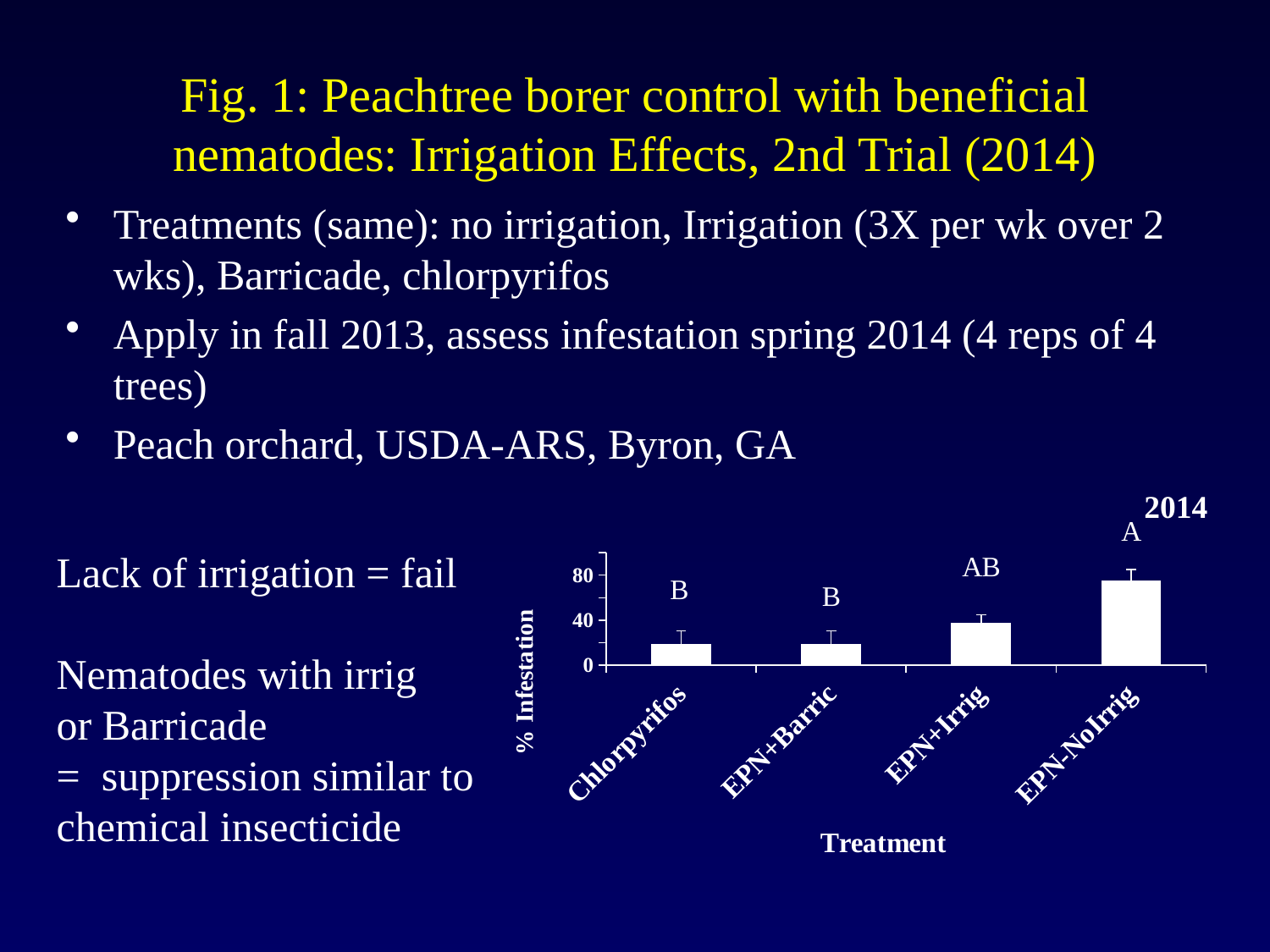
What is the label on the y axis of the chart? % Infestation What kind of chart is shown on the slide? bar chart Is the value for Chlorpyrifos greater or less than 40? less Do the bar values generally rise or fall moving from left to right along the x axis? rise Is the value for EPN+Barric greater or less than 40? less Is the value for EPN-NoIrrig greater or less than 40? greater Which treatment has the highest % Infestation? EPN-NoIrrig Which has a higher % Infestation, Chlorpyrifos or EPN+Irrig? EPN+Irrig How many treatment categories are plotted on the x axis? 4 Which has a higher % Infestation, EPN+Irrig or EPN-NoIrrig? EPN-NoIrrig What statistical grouping letter is shown above the EPN-NoIrrig bar? A